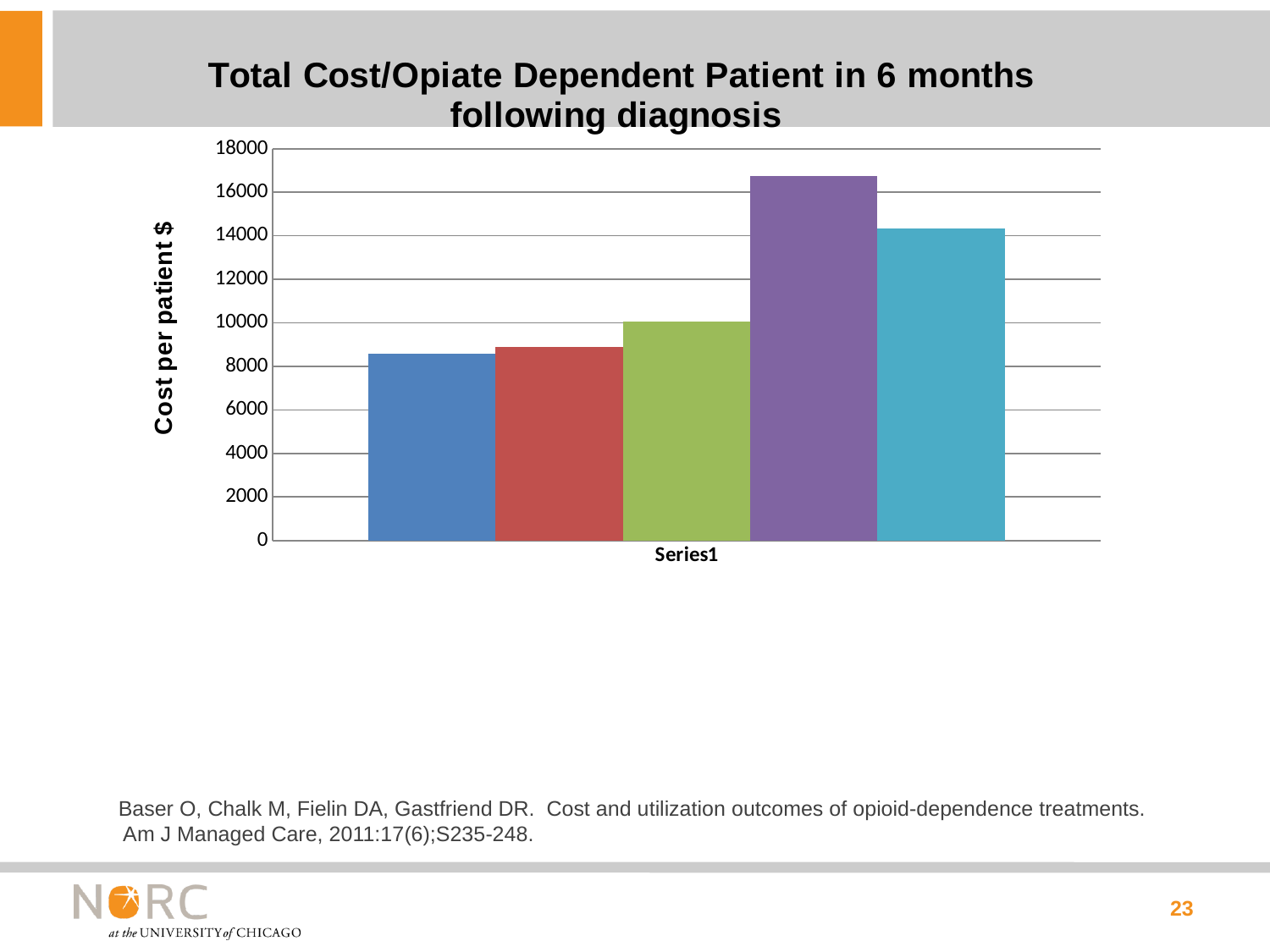
Is the value of the purple (fourth) bar greater or less than 16000? greater What kind of chart is shown on the slide? bar chart Is the value of the green (third) bar greater or less than 12000? less How many bars are plotted in the chart? 5 Which is larger, the purple (fourth) bar or the teal (fifth) bar? the purple (fourth) bar Is the value of the red (second) bar greater or less than 10000? less What is the title of the chart? Total Cost/Opiate Dependent Patient in 6 months following diagnosis Which bar is the tallest in the chart? the fourth (purple) bar What is the label on the vertical axis of the chart? Cost per patient $ Which bar is the shortest in the chart? the first (blue) bar